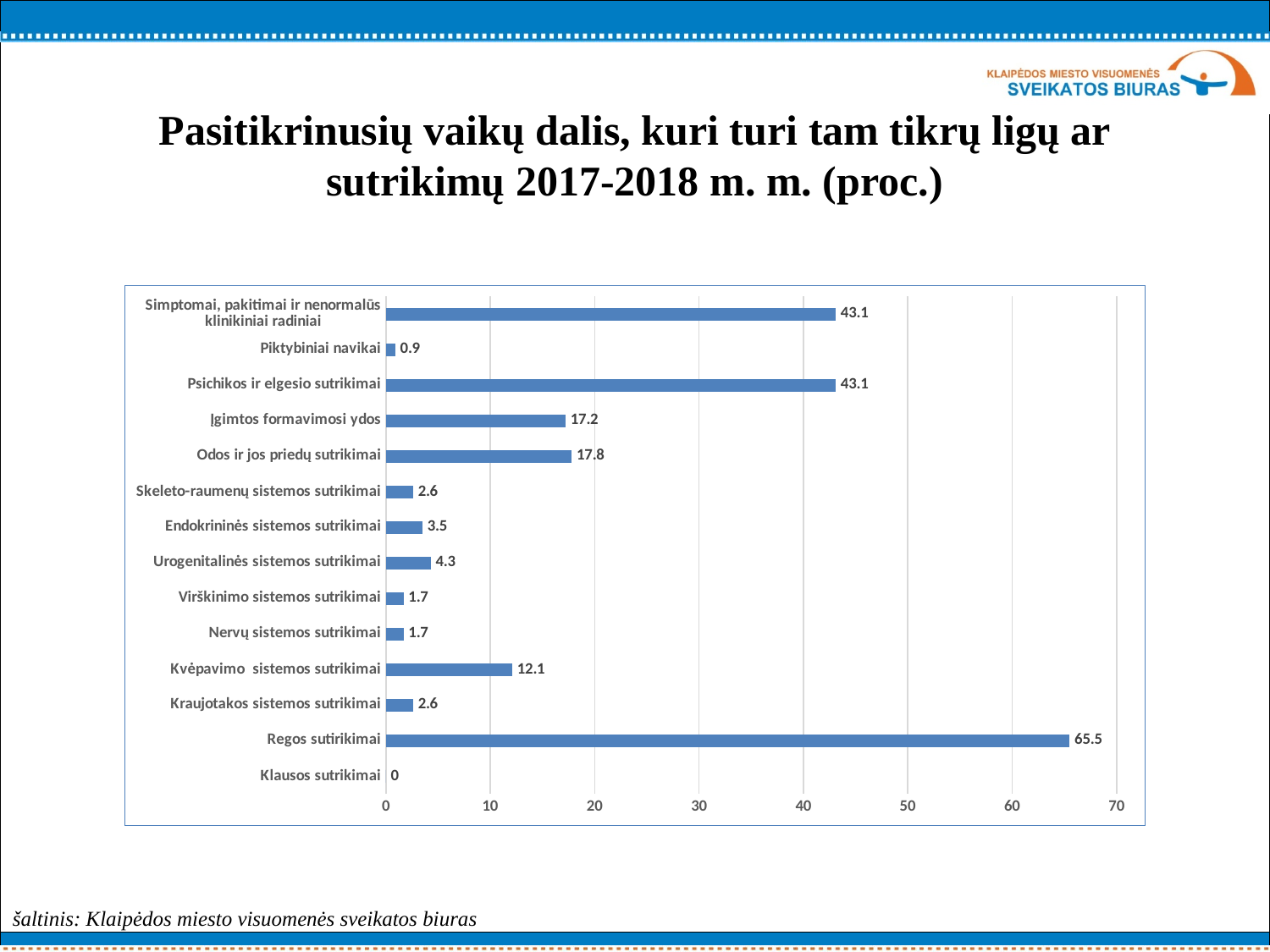
What is the value for Piktybiniai navikai? 0.9 What is the difference between the values for Regos sutrikimai and Psichikos ir elgesio sutrikimai? 22.4 Is the value for Regos sutrikimai greater or less than 60? greater Which is larger, the value for Kvėpavimo sistemos sutrikimai or Urogenitalinės sistemos sutrikimai? Kvėpavimo sistemos sutrikimai What is the value for Regos sutrikimai? 65.5 What is the value for Odos ir jos priedų sutrikimai? 17.8 What is the value for Kvėpavimo sistemos sutrikimai? 12.1 Which category has the lowest value? Klausos sutrikimai How many categories are shown in the chart? 14 Which category has the highest value? Regos sutrikimai What is the difference between the values for Odos ir jos priedų sutrikimai and Įgimtos formavimosi ydos? 0.6 What kind of chart is shown on the slide? bar chart